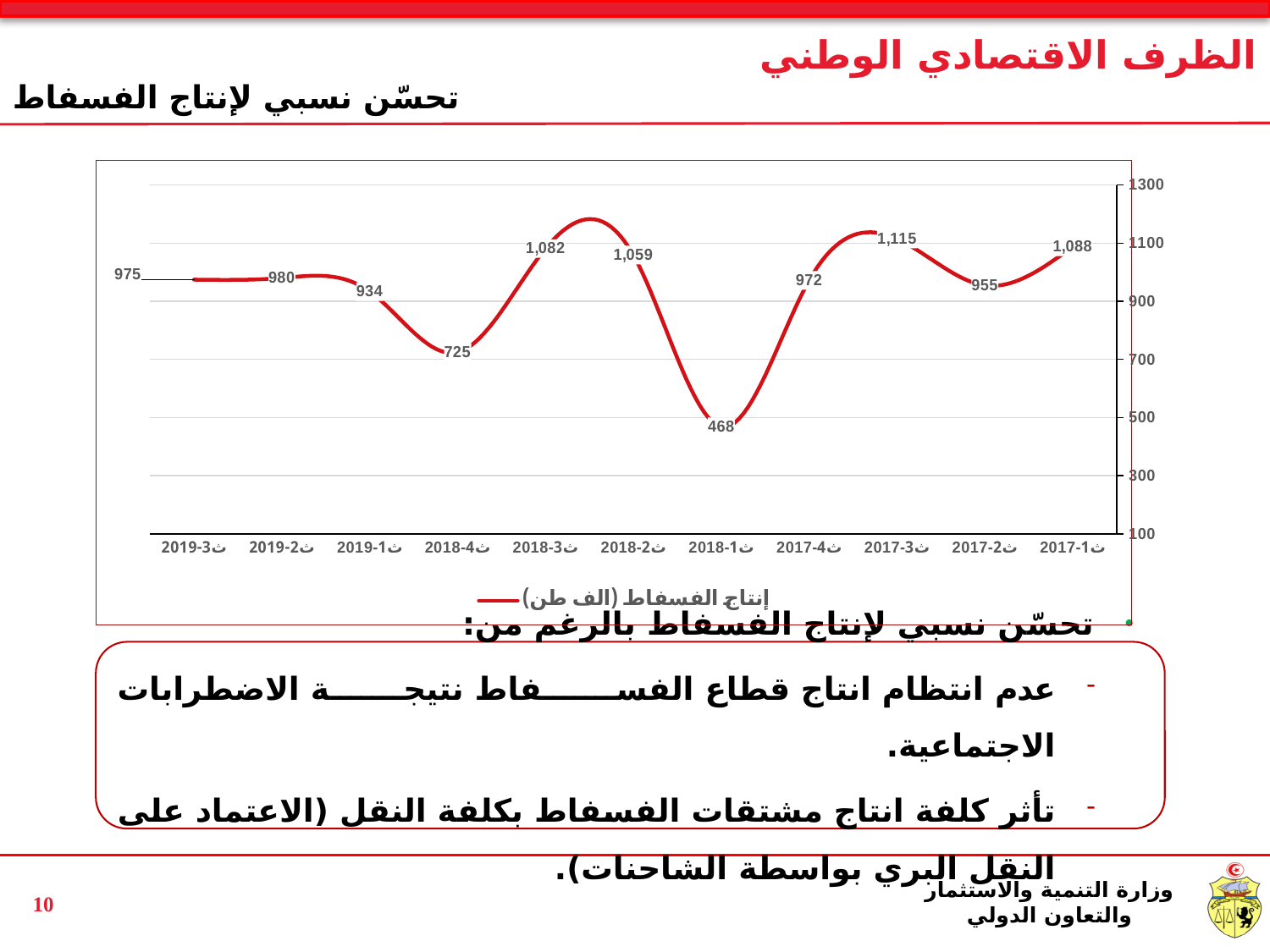
What is the difference between the values for ث3-2018 and ث4-2018? 357 What is the legend entry for the plotted series? إنتاج الفسفاط (الف طن) What type of chart is shown on the slide? line chart What is the value shown for ث4-2018? 725 Which is larger, the value for ث1-2017 or the value for ث2-2017? ث1-2017 What is the phosphate production value for ث3-2017? 1,115 Which quarter has the lowest phosphate production value? ث1-2018 Which quarter has the highest phosphate production value? ث3-2017 What is the phosphate production value for ث1-2018? 468 How many series does the legend list? 1 How many quarters are plotted on the x axis? 11 What is the value shown for ث3-2019? 975